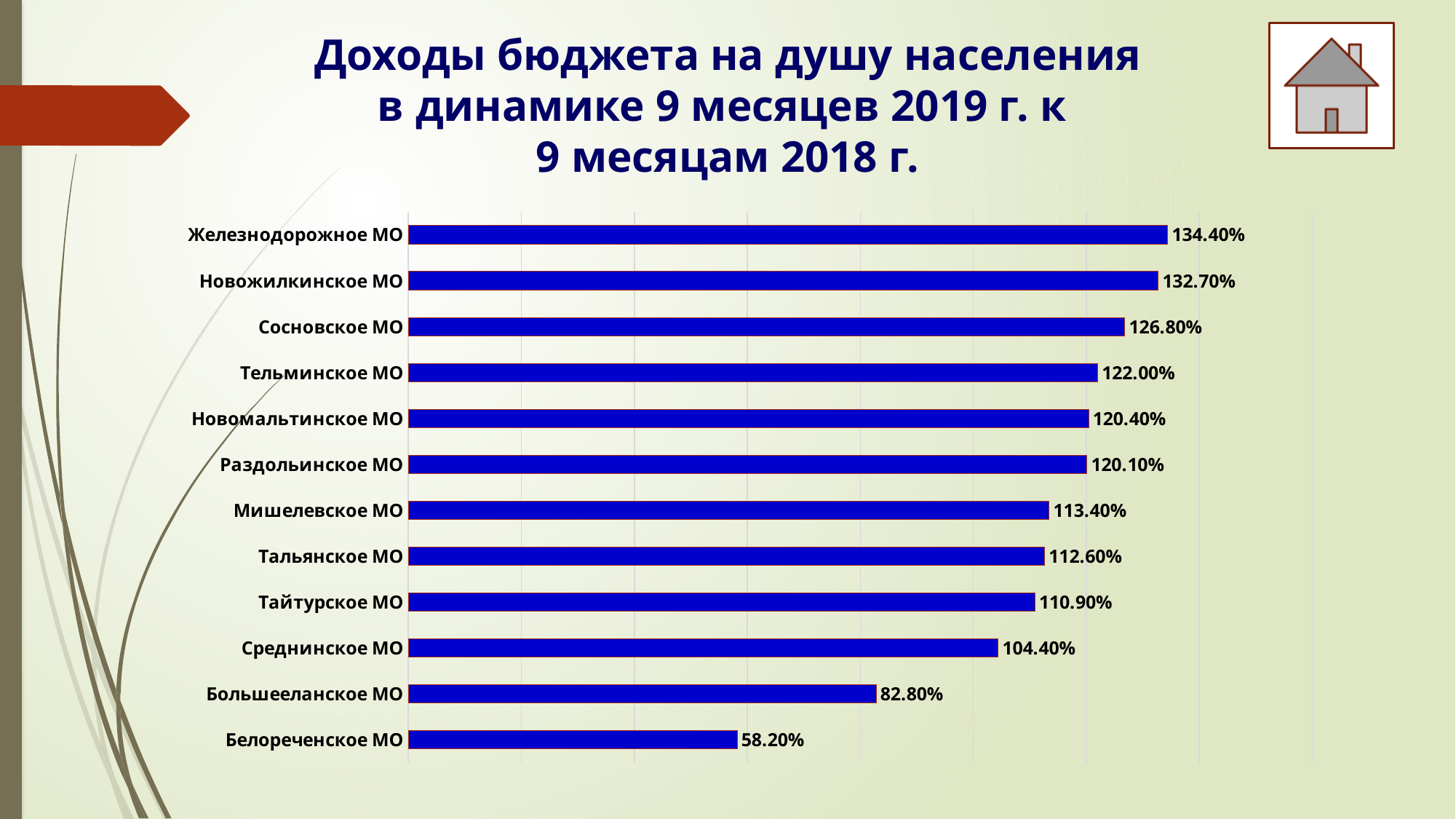
What is the value for Белореченское МО? 58.20% What is the difference between the values for Большееланское МО and Белореченское МО? 24.60% What is the value for Среднинское МО? 104.40% How many categories are shown in the chart? 12 What is the difference between the values for Железнодорожное МО and Новожилкинское МО? 1.70% What is the value for Тайтурское МО? 110.90% What colour are the bars in the chart? Blue Which category has the highest value? Железнодорожное МО What kind of chart is shown on the slide? Bar chart Which is larger, the value for Сосновское МО or the value for Тельминское МО? Сосновское МО What is the value for Железнодорожное МО? 134.40% Which category has the lowest value? Белореченское МО